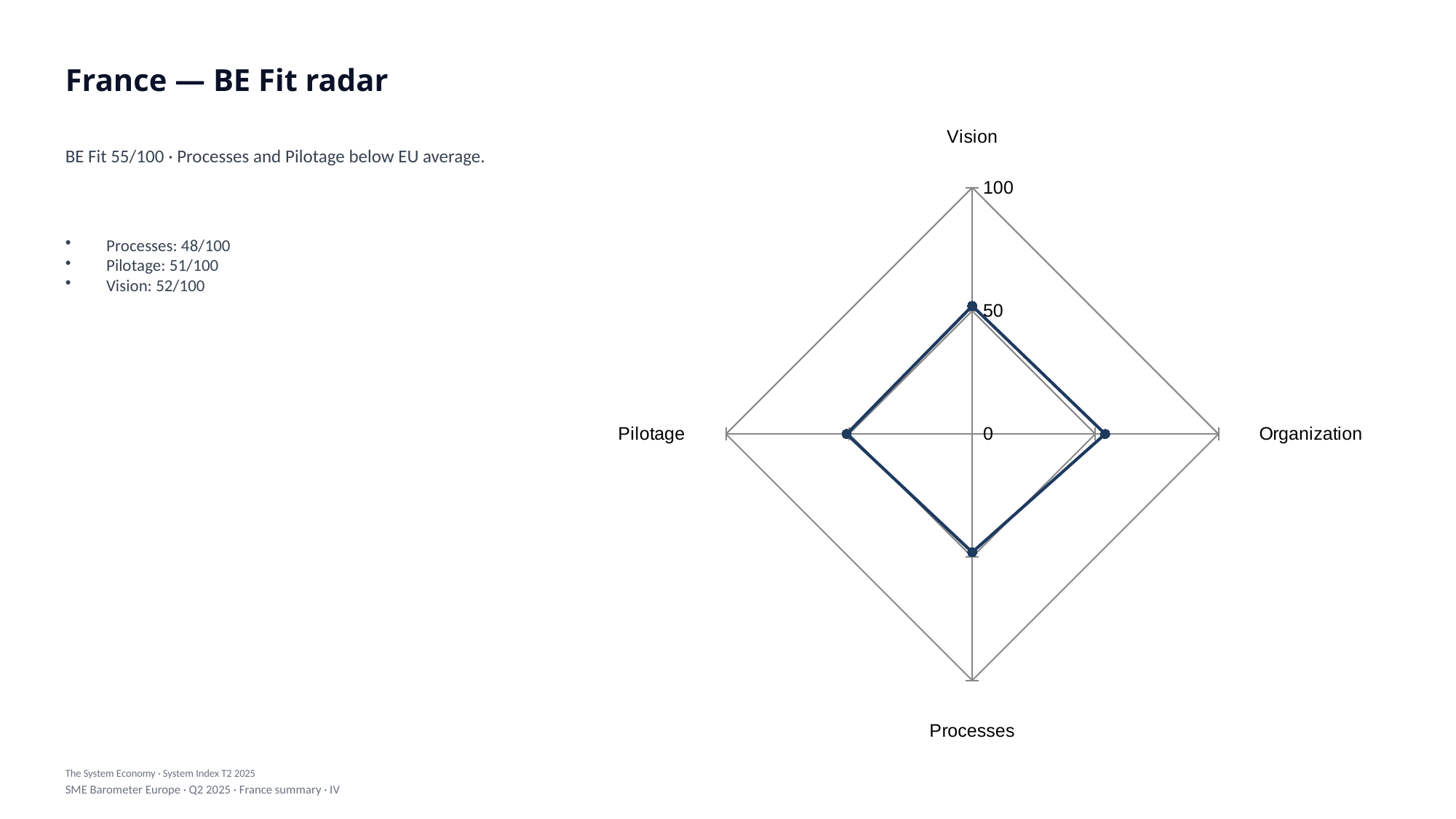
What is the value for Processes? 48/100 What is the maximum value shown on the radar chart's axis scale? 100 Is the value for Processes greater or less than 50? less What is the value for Pilotage? 51/100 How many axes (categories) does the radar chart have? 4 What is the title of the chart slide? France — BE Fit radar What is the difference between the Pilotage and Processes values? 3 What kind of chart is shown on the slide? radar chart What is the difference between the Vision and Processes values? 4 What is the value for Vision? 52/100 Which is larger, the value for Vision or the value for Processes? Vision Which category has the lowest value on the radar chart? Processes